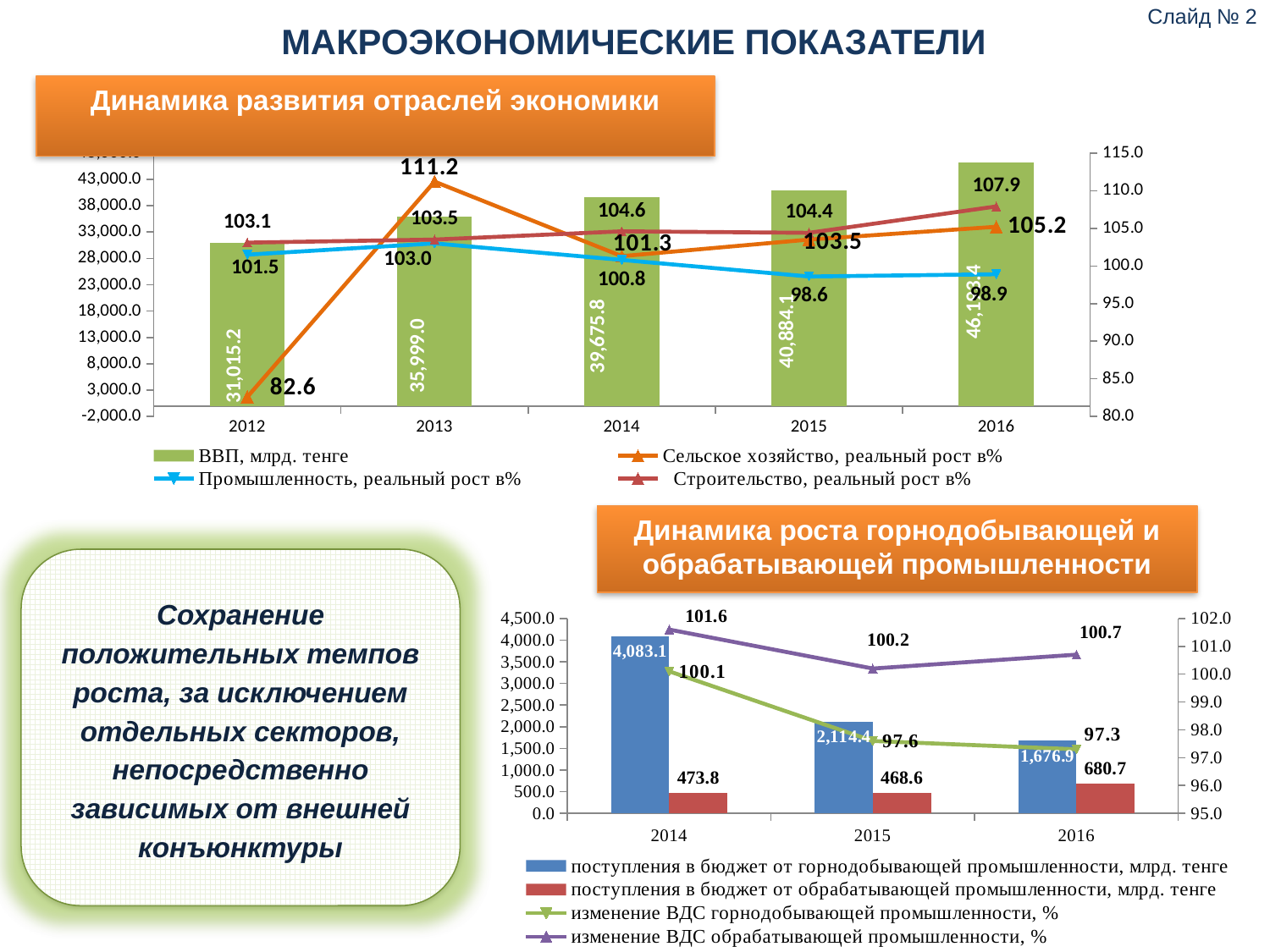
In the chart 'Динамика развития отраслей экономики', in which year is Сельское хозяйство, реальный рост в% highest? 2013 In the chart 'Динамика роста горнодобывающей и обрабатывающей промышленности', what is the value of поступления в бюджет от обрабатывающей промышленности for 2016? 680.7 In the chart 'Динамика развития отраслей экономики', what is the difference between ВВП for 2014 and ВВП for 2012? 8,660.6 In the chart 'Динамика развития отраслей экономики', what is the value of Сельское хозяйство, реальный рост в% for 2012? 82.6 In the chart 'Динамика развития отраслей экономики', what is the value of ВВП, млрд. тенге for 2013? 35,999.0 In the chart 'Динамика роста горнодобывающей и обрабатывающей промышленности', what is the difference between поступления в бюджет от горнодобывающей промышленности for 2014 and 2015? 1,968.7 In the chart 'Динамика роста горнодобывающей и обрабатывающей промышленности', in which year is поступления в бюджет от горнодобывающей промышленности highest? 2014 In the chart 'Динамика роста горнодобывающей и обрабатывающей промышленности', which is larger in 2015: изменение ВДС горнодобывающей промышленности or изменение ВДС обрабатывающей промышленности? изменение ВДС обрабатывающей промышленности In the chart 'Динамика роста горнодобывающей и обрабатывающей промышленности', how many years are shown on the x axis? 3 In the chart 'Динамика развития отраслей экономики', does Строительство, реальный рост в% rise or fall from 2015 to 2016? rise In the chart 'Динамика развития отраслей экономики', how many series does the legend list? 4 In the chart 'Динамика развития отраслей экономики', in which year is Промышленность, реальный рост в% lowest? 2015